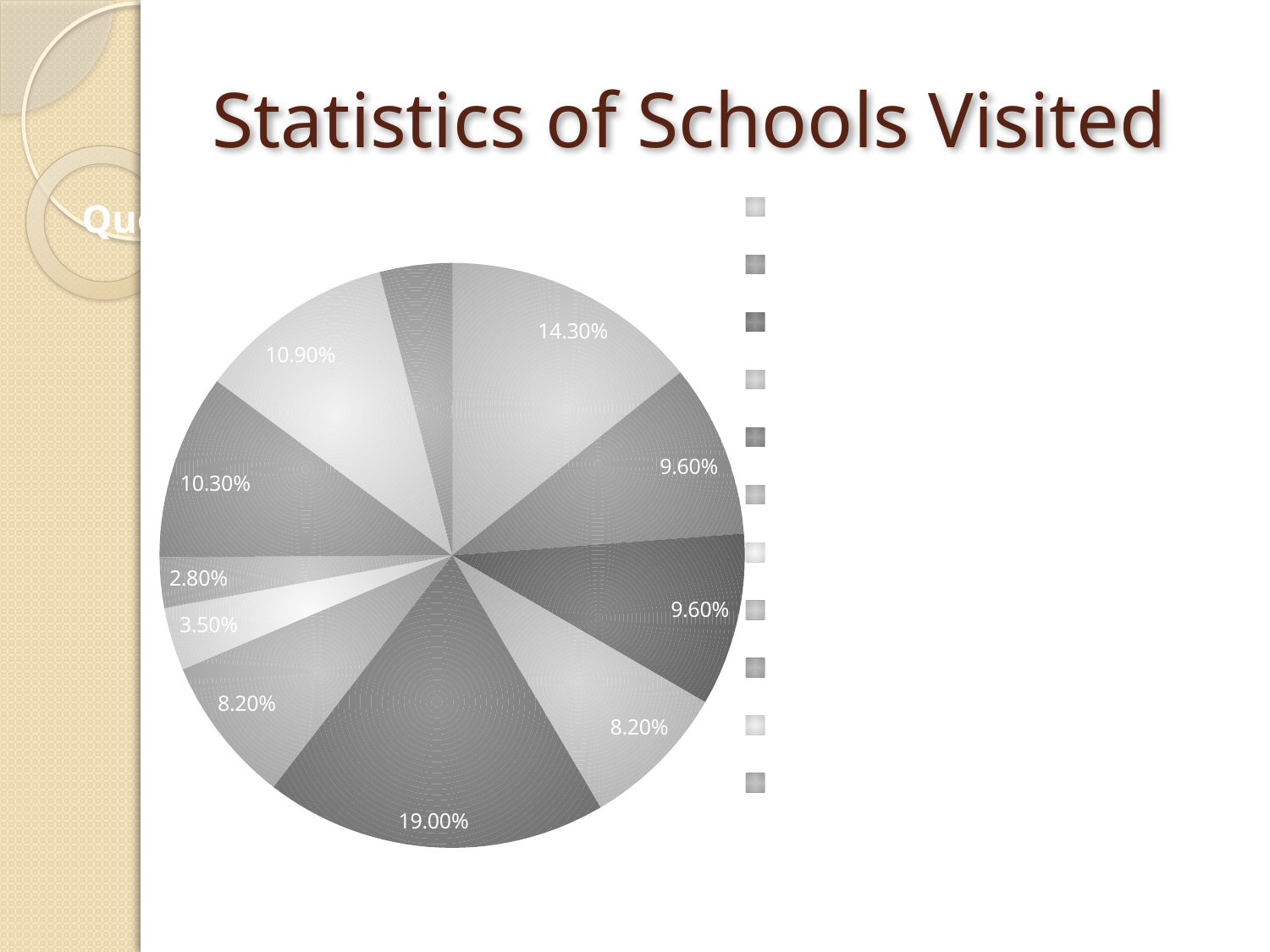
What is the difference between the 3.50% slice and the 2.80% slice? 0.70% How many slices does the pie chart have? 11 How many slices are labelled 9.60%? 2 Is the largest slice of the pie chart greater or less than 15%? greater What is the value of the largest slice in the pie chart? 19.00% What is the difference between the largest slice (19.00%) and the 14.30% slice? 4.70% How many entries does the legend list? 11 What kind of chart is shown on the slide? pie chart Which is larger, the 10.90% slice or the 10.30% slice? 10.90% How many slices are labelled 8.20%? 2 What is the second-largest labelled value in the pie chart? 14.30%